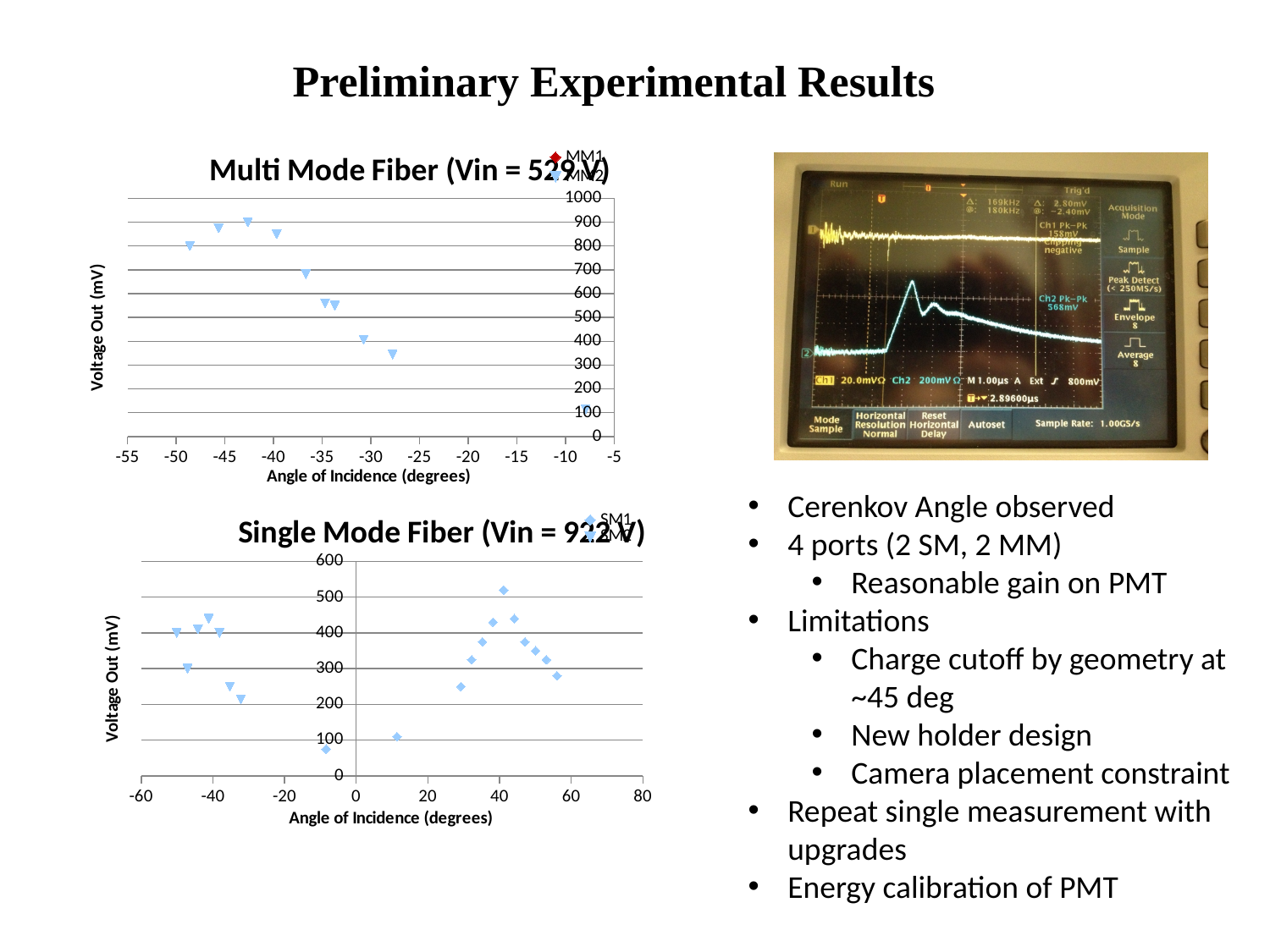
In the Single Mode Fiber chart, do the voltages rise or fall as the angle goes from 42 to 56 degrees? fall In the Single Mode Fiber chart, is the voltage at about -8 degrees greater or less than 100? less How many series does the legend of the Multi Mode Fiber chart list? 2 In the Multi Mode Fiber chart, do the voltages rise or fall as the angle goes from -45 to -25 degrees? fall How many series does the legend of the Single Mode Fiber chart list? 2 What is the y-axis title of the Multi Mode Fiber chart? Voltage Out (mV) In the Multi Mode Fiber chart, is the voltage at about -45 degrees greater or less than 800? greater In the Multi Mode Fiber chart, is the voltage at about -27 degrees greater or less than 400? less What kind of chart is the Multi Mode Fiber chart? scatter chart What is the x-axis title of the Single Mode Fiber chart? Angle of Incidence (degrees)